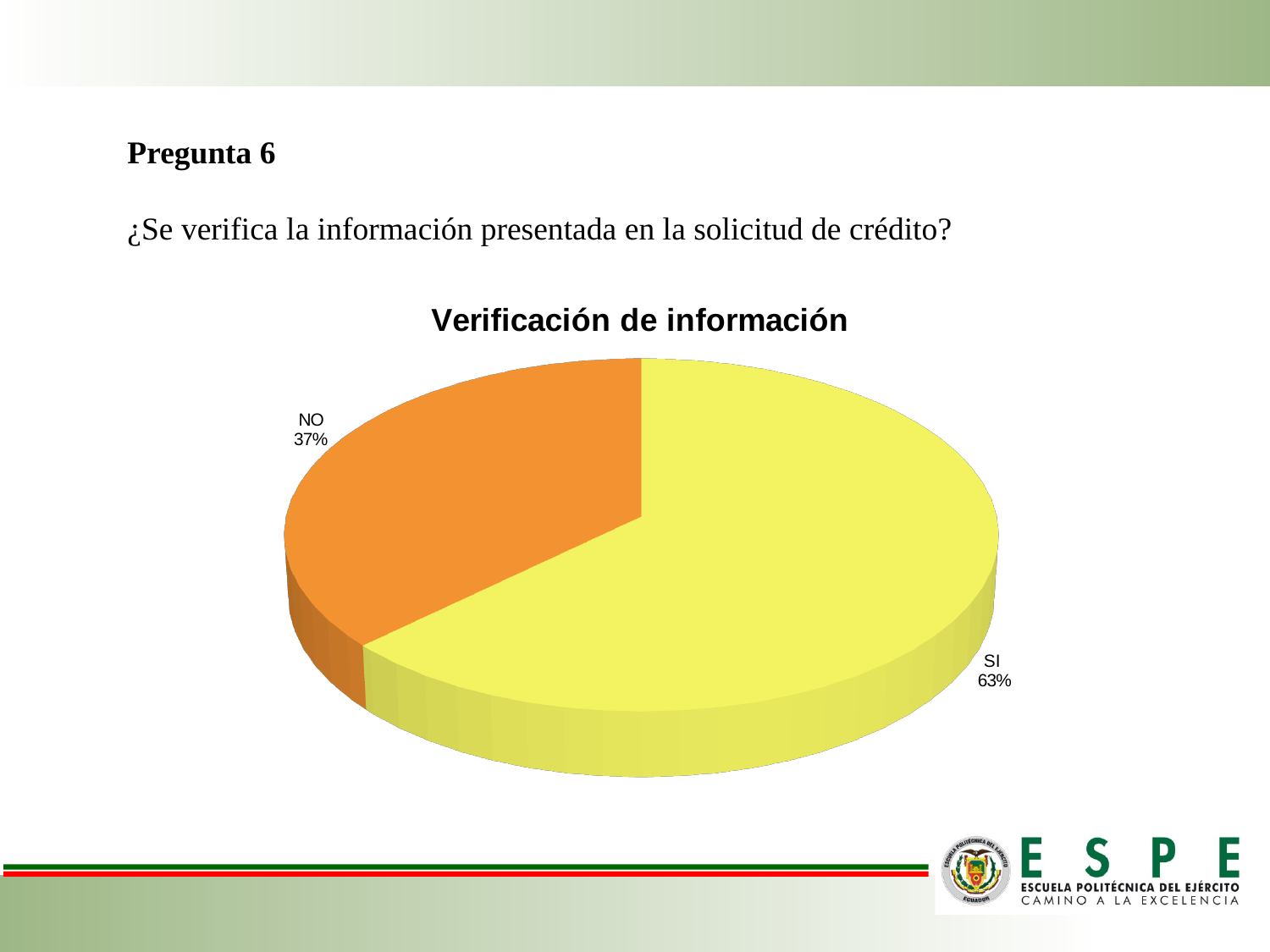
What type of chart is shown on the slide? pie chart Which slice is the smallest in the pie chart? NO What is the share of the NO slice in the pie? 37% What is the title of the chart? Verificación de información How many slices does the pie chart have? 2 What percentage of the pie does the SI slice represent? 63% What is the difference in percentage points between the SI and NO slices? 26 What percentage of the pie does the NO slice represent? 37% Which slice is the largest in the pie chart? SI What colour is the SI slice? yellow Which slice is larger, SI or NO? SI